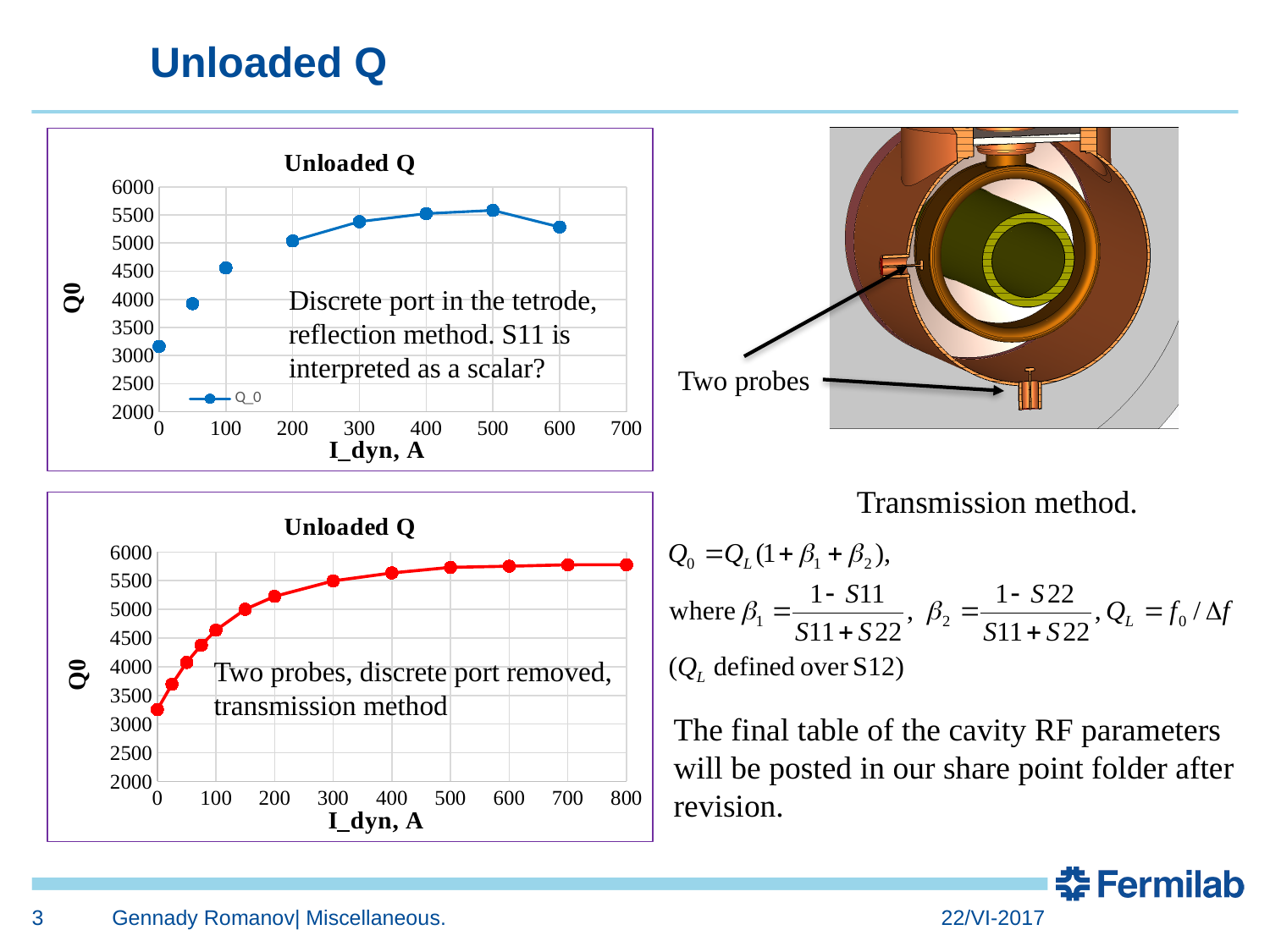
In the top-left chart, is the value of Q0 at I_dyn = 600 greater or less than 5500? less In the top-left chart, how many data points are plotted? 8 In the top-left chart, is the value of Q0 at I_dyn = 0 greater or less than 3500? less In the top-left chart, what is the legend entry for the plotted series? Q_0 In the top-left chart, does Q0 rise or fall between I_dyn = 500 and I_dyn = 600? fall In the bottom-left chart, is the value of Q0 at I_dyn = 800 greater or less than 5500? greater What type of chart is the top-left chart titled 'Unloaded Q'? line chart In the bottom-left chart, does Q0 generally rise or fall as I_dyn increases? rise In the bottom-left chart, what is the x-axis title? I_dyn, A In the bottom-left chart, at which I_dyn value is Q0 lowest? 0 In the top-left chart, at which I_dyn value is Q0 lowest? 0 In the top-left chart, which has the larger Q0: I_dyn = 100 or I_dyn = 200? I_dyn = 200